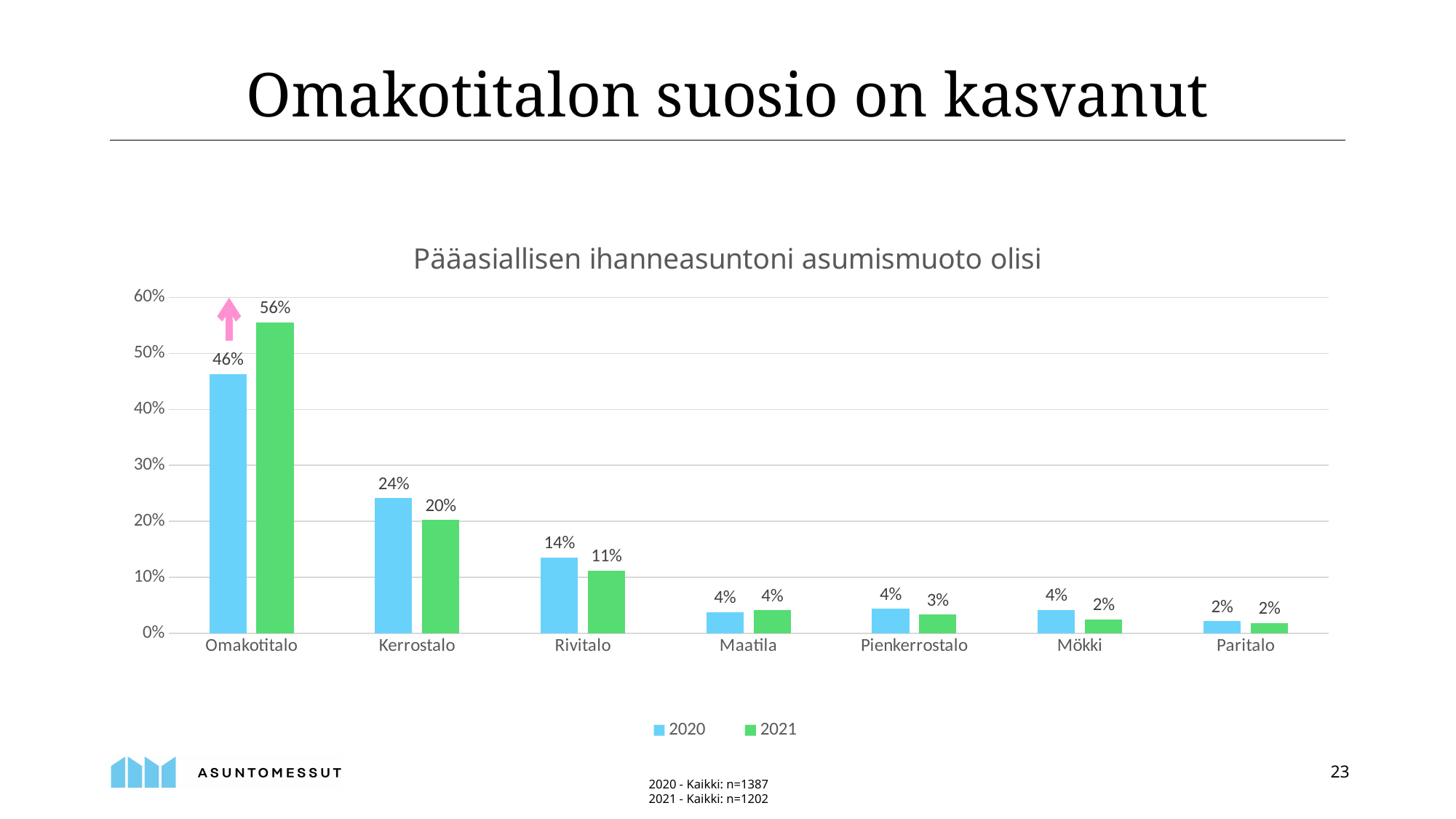
Which category has the lowest 2020 value? Paritalo How many categories are shown on the x axis? 7 What is the title of the chart? Pääasiallisen ihanneasuntoni asumismuoto olisi What is the 2020 value for Kerrostalo? 24% What kind of chart is shown on the slide? bar chart What is the 2021 value for Omakotitalo? 56% Which is larger for Kerrostalo, the 2020 value or the 2021 value? 2020 What is the difference between the 2021 and 2020 values for Omakotitalo? 10% Is the 2020 value for Omakotitalo greater or less than 40%? greater Which category has the highest 2021 value? Omakotitalo What is the 2021 value for Rivitalo? 11% How many series does the legend list? 2